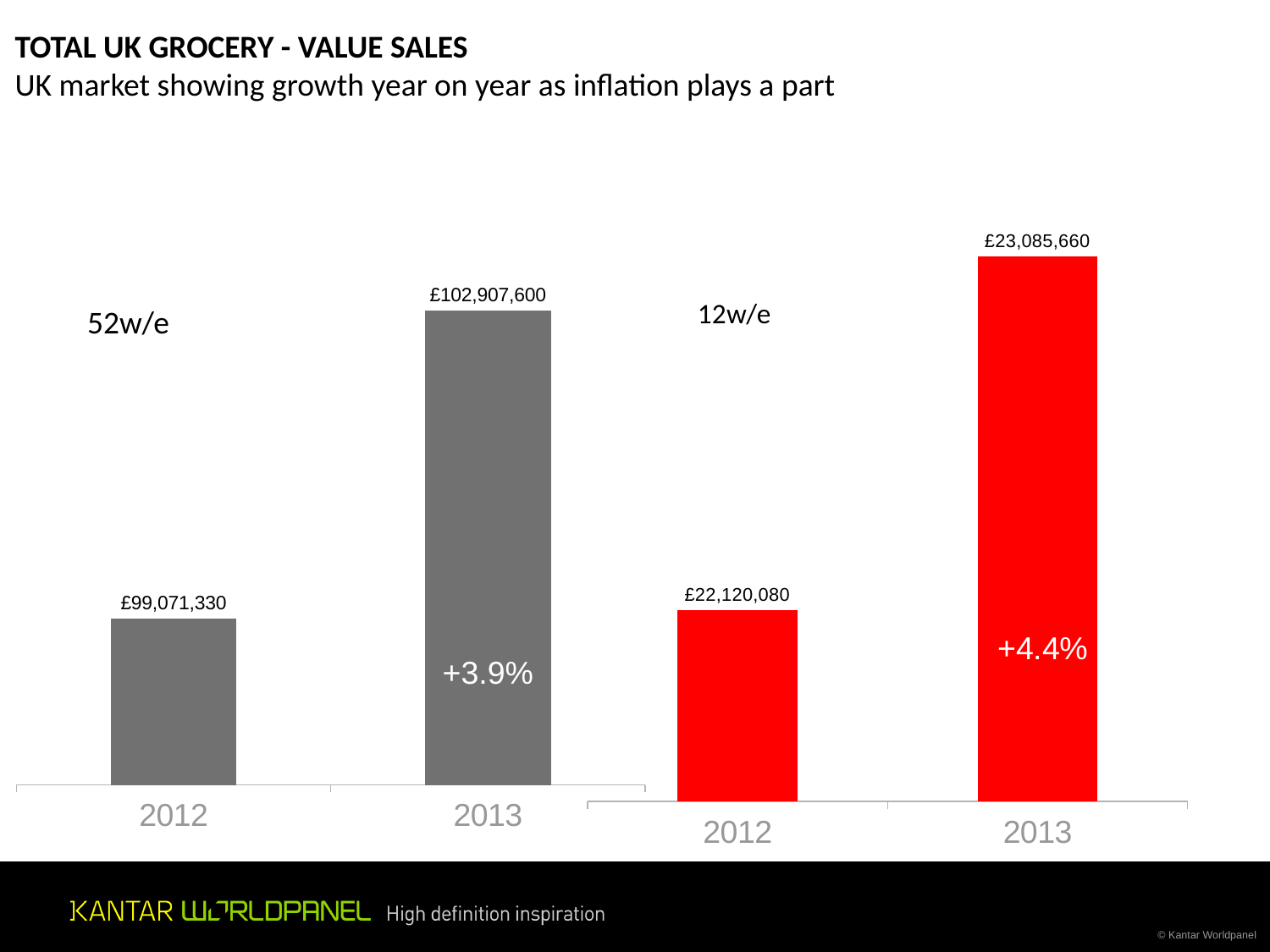
In the 12w/e chart on the right, which year has the higher value? 2013 What kind of chart is the 52w/e chart on the left? Bar chart In the 52w/e chart on the left, which year has the lower value? 2012 How many bars are in the 52w/e chart on the left? 2 In the 12w/e chart on the right, what is the value for 2012? £22,120,080 In the 12w/e chart on the right, what is the value for 2013? £23,085,660 In the 52w/e chart on the left, what is the value for 2013? £102,907,600 In the 12w/e chart on the right, what is the difference between the 2013 and 2012 values? £965,580 What percentage growth is printed on the 2013 bar in the 12w/e chart on the right? +4.4% In the 52w/e chart on the left, what is the value for 2012? £99,071,330 In the 12w/e chart on the right, do the values rise or fall from 2012 to 2013? Rise In the 52w/e chart on the left, what is the difference between the 2013 and 2012 values? £3,836,270